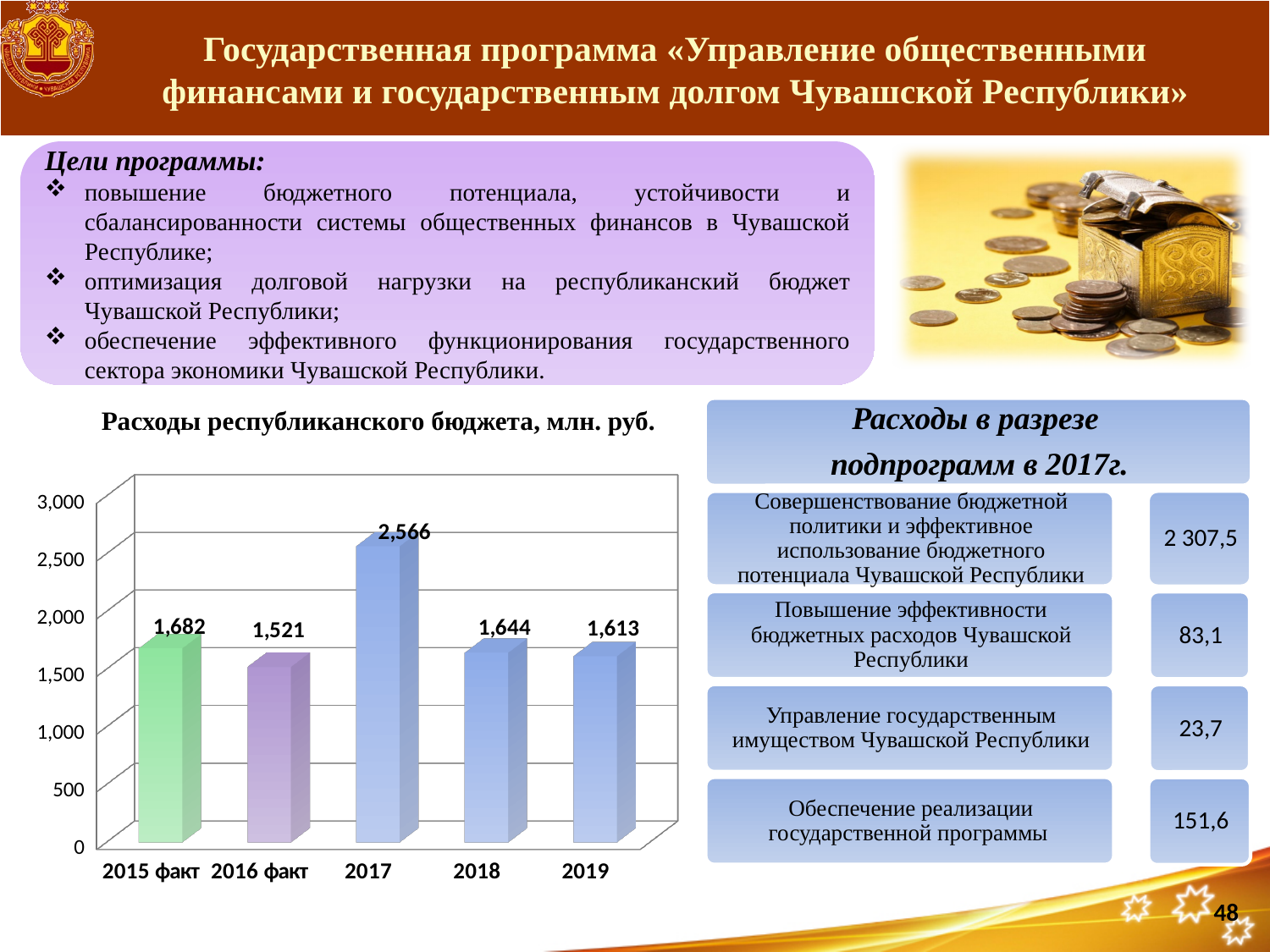
Which is larger, the value for 2018 or the value for 2019? 2018 What is the title of the chart on the slide? Расходы республиканского бюджета, млн. руб. What is the difference between the values for 2017 and 2018? 922 How many bars are shown in the chart? 5 What is the value for 2016 факт in the chart? 1,521 What is the difference between the values for 2015 факт and 2016 факт? 161 Which year has the lowest value in the chart? 2016 факт What is the value for 2017 in the chart "Расходы республиканского бюджета, млн. руб."? 2,566 What kind of chart is shown on the slide? bar chart Is the value for 2017 greater or less than 2,500? greater Which year has the highest value in the chart? 2017 What is the value for 2019 in the chart? 1,613